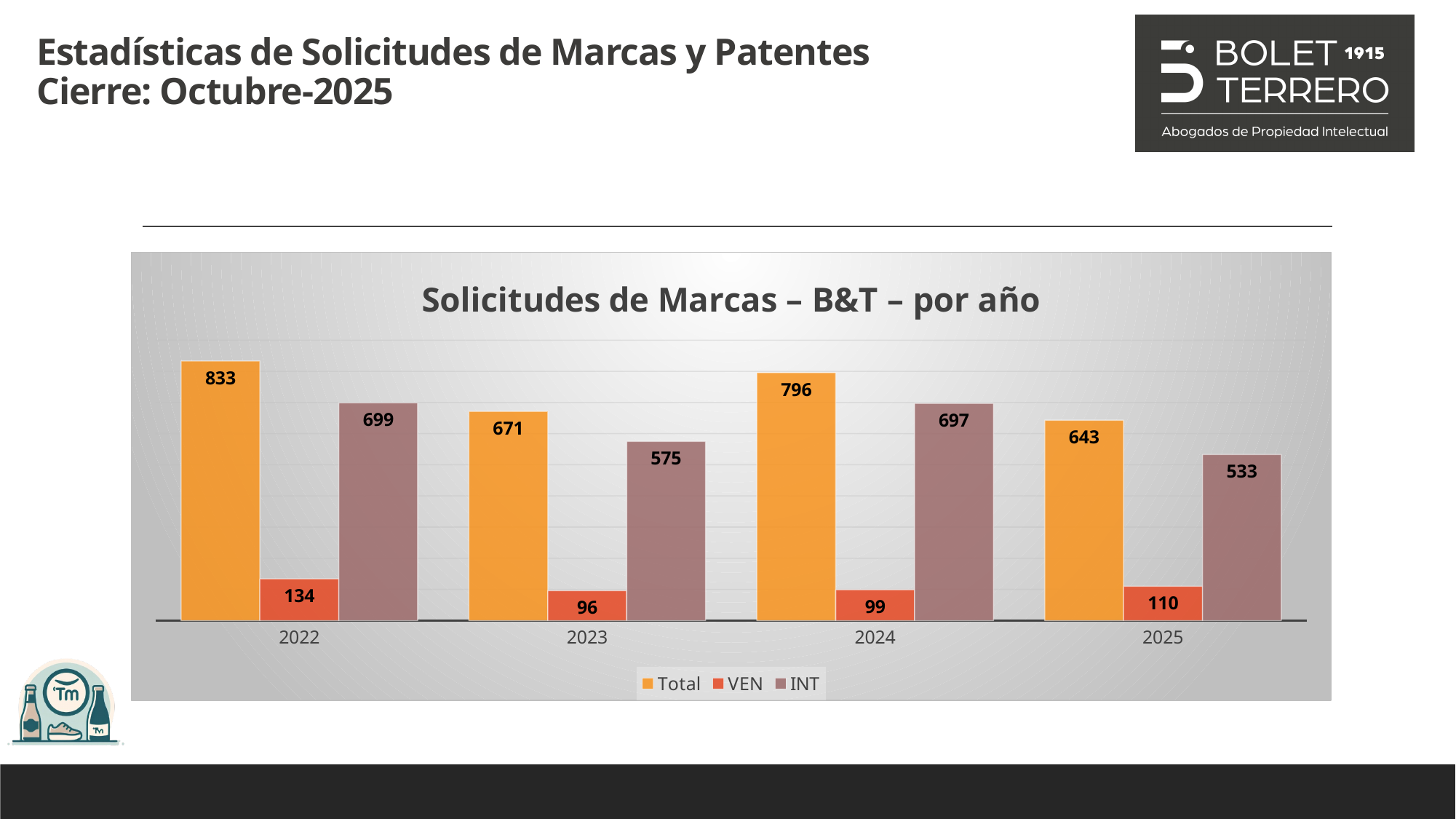
How many series does the legend list? 3 Which year has the lowest VEN value? 2023 What kind of chart is shown on the slide? Bar chart How many years are shown on the x axis? 4 Which year has the highest Total value? 2022 What is the INT value for 2025? 533 What is the Total value for 2022? 833 Which is larger, the VEN value for 2022 or the VEN value for 2025? 2022 What is the VEN value for 2023? 96 What is the title of the chart? Solicitudes de Marcas – B&T – por año What is the difference between the INT values for 2024 and 2023? 122 What is the difference between the Total values for 2022 and 2025? 190